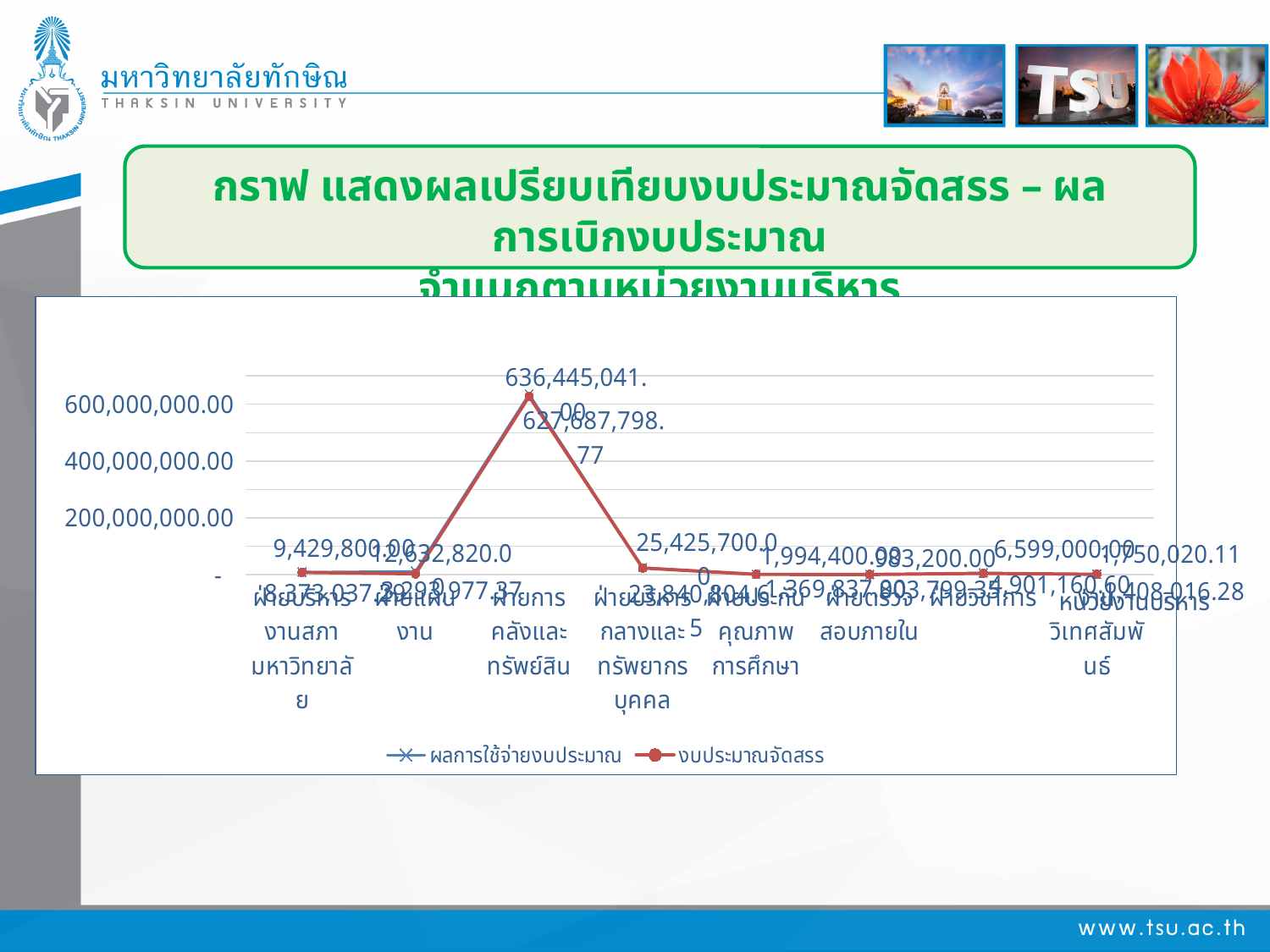
How many series does the legend list? 2 What is the งบประมาณจัดสรร value for ฝ่ายการคลังและทรัพย์สิน? 627,687,798.77 Which is larger: the งบประมาณจัดสรร value for ฝ่ายการคลังและทรัพย์สิน or for ฝ่ายบริหารกลางและทรัพยากรบุคคล? ฝ่ายการคลังและทรัพย์สิน What kind of chart is shown on the slide? line chart What is the งบประมาณจัดสรร value for ฝ่ายบริหารกลางและทรัพยากรบุคคล? 23,840,804.65 How many units (categories) are plotted along the x axis? 8 What is the งบประมาณจัดสรร value for ฝ่ายวิชาการ? 4,901,160.60 Is the งบประมาณจัดสรร value for ฝ่ายการคลังและทรัพย์สิน greater or less than 600,000,000.00? greater What is the ผลการใช้จ่ายงบประมาณ value for ฝ่ายการคลังและทรัพย์สิน? 636,445,041.00 What are the two series named in the legend? ผลการใช้จ่ายงบประมาณ and งบประมาณจัดสรร What is the difference between งบประมาณจัดสรร and ผลการใช้จ่ายงบประมาณ for ฝ่ายการคลังและทรัพย์สิน? 8,757,242.23 Which unit has the highest งบประมาณจัดสรร value? ฝ่ายการคลังและทรัพย์สิน